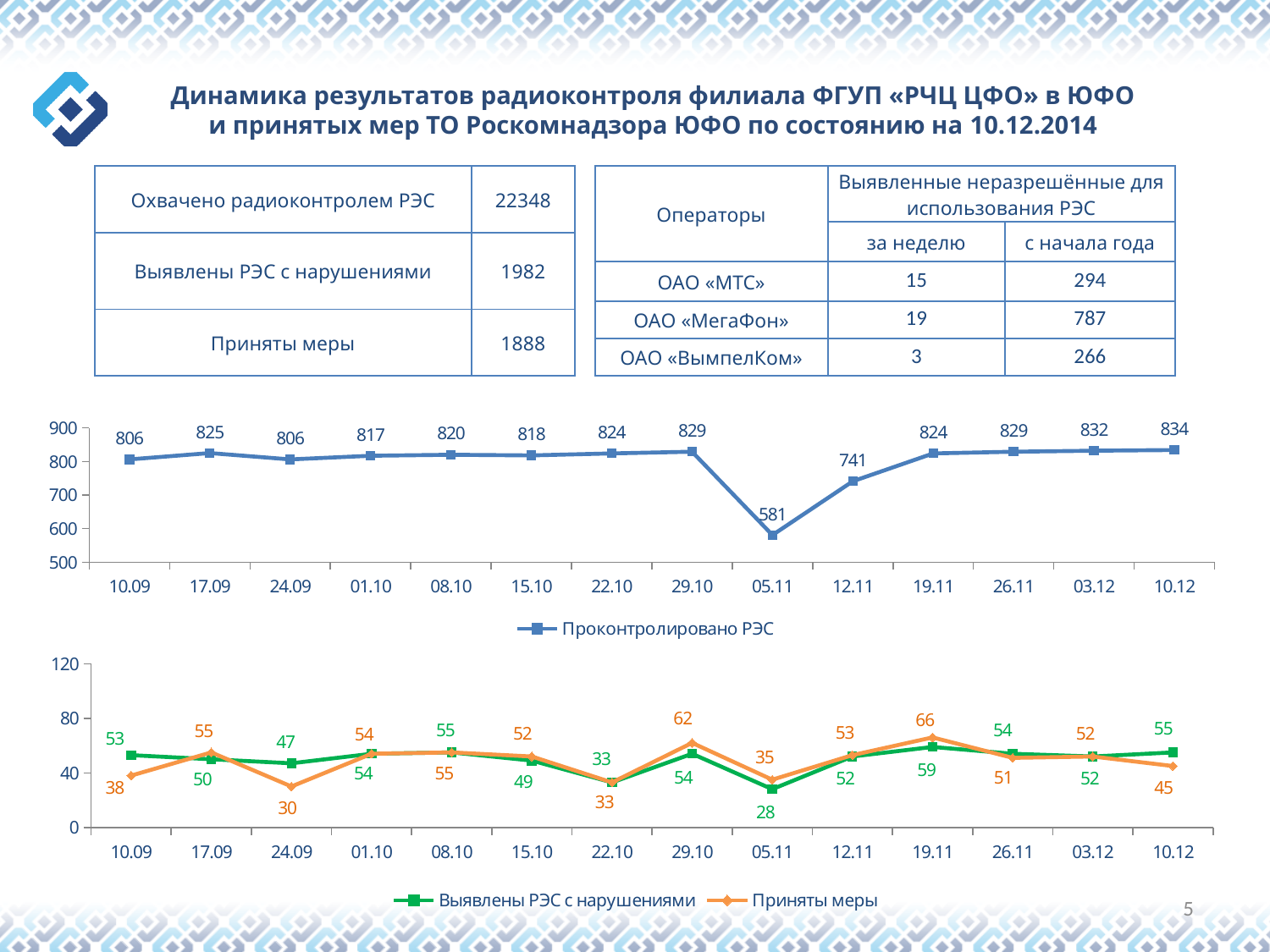
In the bottom chart, which date has the lowest value for Выявлены РЭС с нарушениями? 05.11 How many series does the legend of the bottom chart list? 2 In the top chart (Проконтролировано РЭС), which date has the lowest value? 05.11 In the top chart (Проконтролировано РЭС), how many dates are plotted on the x axis? 14 In the top chart (Проконтролировано РЭС), what is the difference between the values for 12.11 and 05.11? 160 In the bottom chart, what is the value of Приняты меры for 19.11? 66 In the top chart (Проконтролировано РЭС), what is the value for 10.12? 834 In the top chart (Проконтролировано РЭС), which date has the highest value? 10.12 In the bottom chart, which is larger for 10.12: Выявлены РЭС с нарушениями or Приняты меры? Выявлены РЭС с нарушениями What type of chart is the top chart (Проконтролировано РЭС)? Line chart In the bottom chart, what is the value of Выявлены РЭС с нарушениями for 05.11? 28 In the top chart (Проконтролировано РЭС), what is the value for 05.11? 581